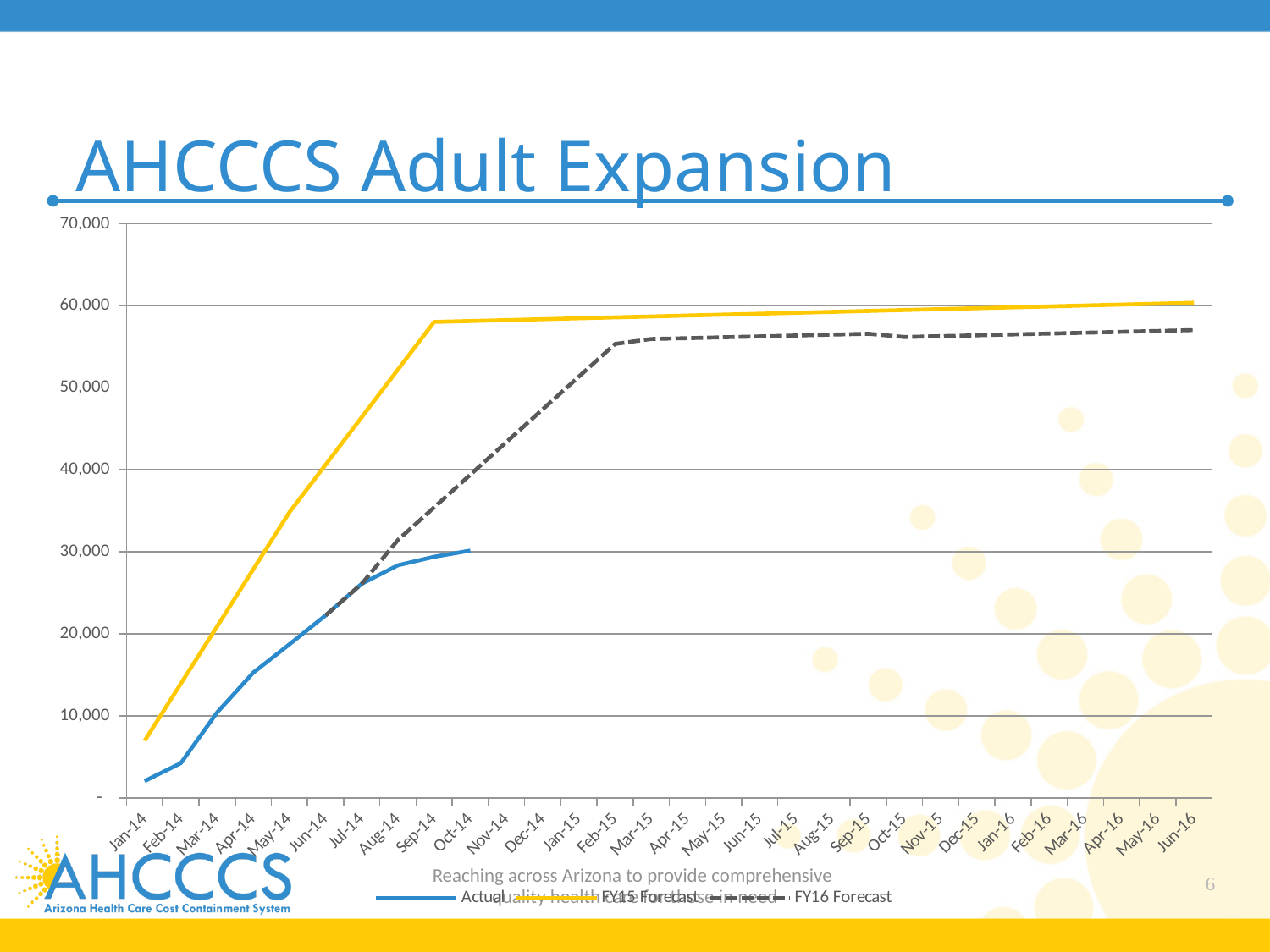
Which series reaches the highest value on the chart? FY15 Forecast At Sep-14, which is larger: the Actual value or the FY16 Forecast value? FY16 Forecast Is the value of the FY16 Forecast series at Sep-14 greater or less than 50,000? less Is the value of the Actual series at Jan-14 greater or less than 10,000? less What is the title of the chart? AHCCCS Adult Expansion What kind of chart is shown on the slide? Line chart Is the value of the FY16 Forecast series at Jul-14 greater or less than 40,000? less How many months are shown on the x axis? 30 Does the Actual series rise or fall from Jan-14 to Oct-14? Rise Which series is drawn as a dashed line? FY16 Forecast How many series does the legend list? 3